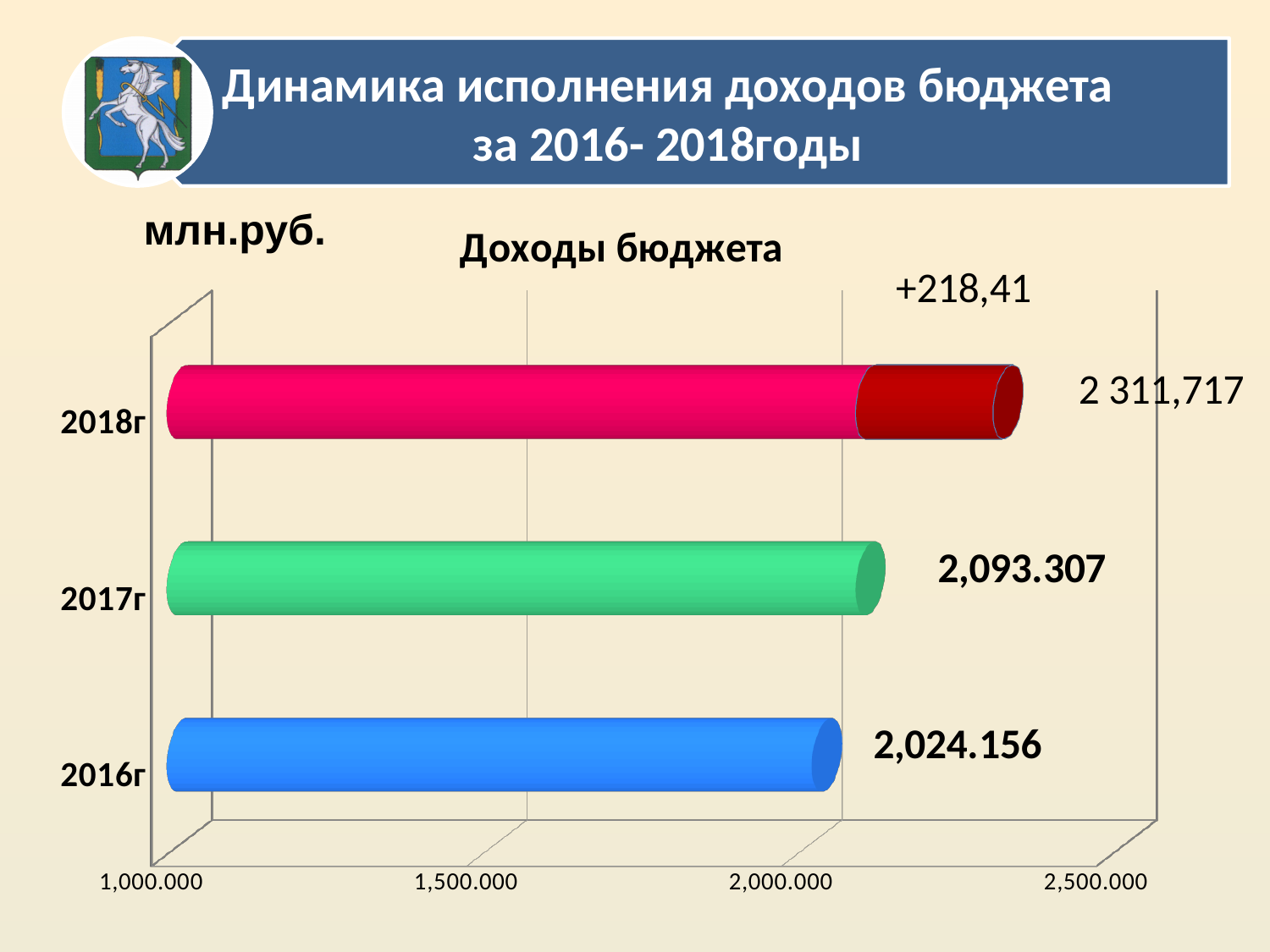
What type of chart is shown on the slide? bar chart Which is larger, the value for 2017г or the value for 2016г? 2017г Do the budget revenues rise or fall from 2016г to 2018г? rise Is the value for 2018г greater or less than 2,500.000? less Which year has the highest budget revenue? 2018г What is the difference between the values for 2017г and 2016г? 69.151 What is the value shown for 2018г? 2 311,717 What is the value shown for 2016г? 2,024.156 How many years (categories) are shown in the chart? 3 What is the value shown for 2017г? 2,093.307 Which year has the lowest budget revenue? 2016г What is the title of the chart? Доходы бюджета